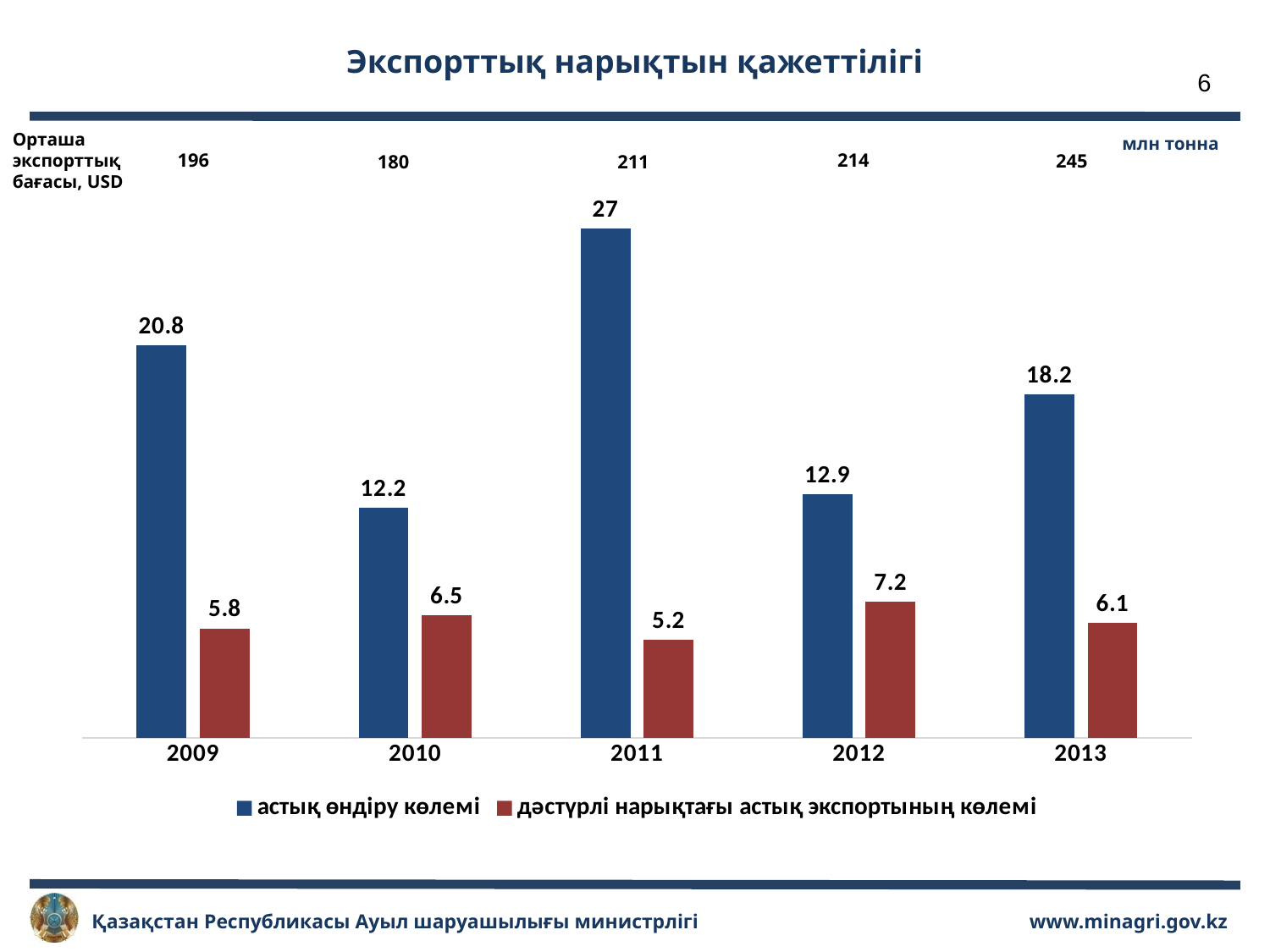
What unit is shown in the top right corner of the chart? млн тонна How many series does the legend list? 2 What kind of chart is shown on the slide? bar chart What is the average export price (Орташа экспорттық бағасы, USD) shown above the 2013 bars? 245 How many years are shown on the x axis? 5 Which is larger: дәстүрлі нарықтағы астық экспортының көлемі in 2010 or in 2013? 2010 What is the value of астық өндіру көлемі for 2011? 27 What is the value of дәстүрлі нарықтағы астық экспортының көлемі for 2012? 7.2 Which year has the highest value for астық өндіру көлемі? 2011 What is the difference between астық өндіру көлемі and дәстүрлі нарықтағы астық экспортының көлемі in 2009? 15 Which year has the lowest value for дәстүрлі нарықтағы астық экспортының көлемі? 2011 What is the value of астық өндіру көлемі for 2013? 18.2